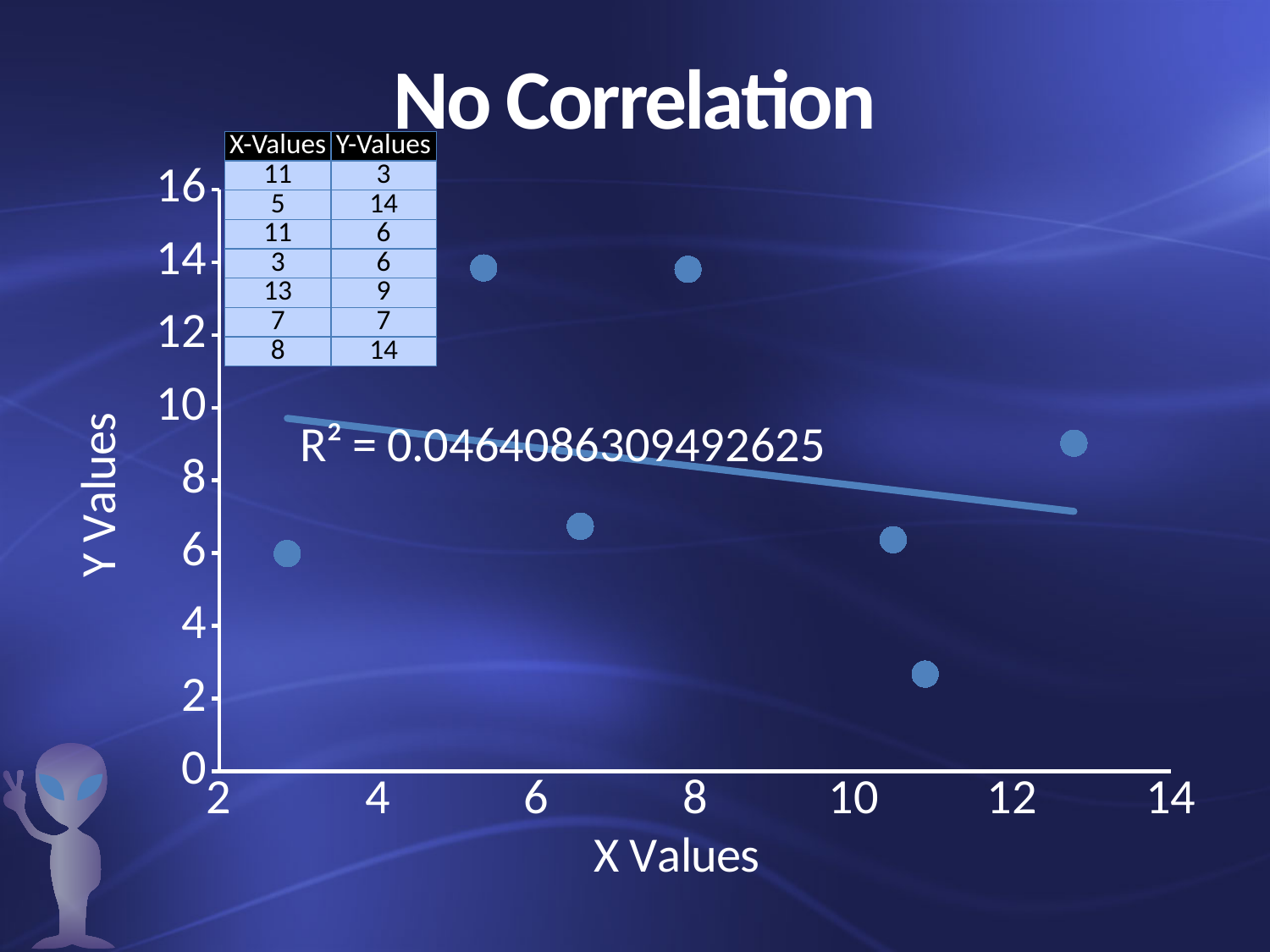
What is the highest Y value plotted on the chart? 14 What is the title of the chart's horizontal axis? X Values Which point has the larger Y value: the one at X = 13 or the one at X = 7? X = 13 What kind of chart is shown on the slide? scatter chart How many data points are plotted on the chart? 7 What is the lowest Y value plotted on the chart? 3 According to the data table, what is the Y value for the point with X value 5? 14 Does the trendline on the chart rise or fall as X increases? fall Is the Y value of the lowest point on the chart greater or less than 4? less According to the data table, what is the Y value for the point with X value 13? 9 What R² value is displayed on the chart? 0.0464086309492625 What is the difference between the Y value at X = 13 and the Y value at X = 3? 3